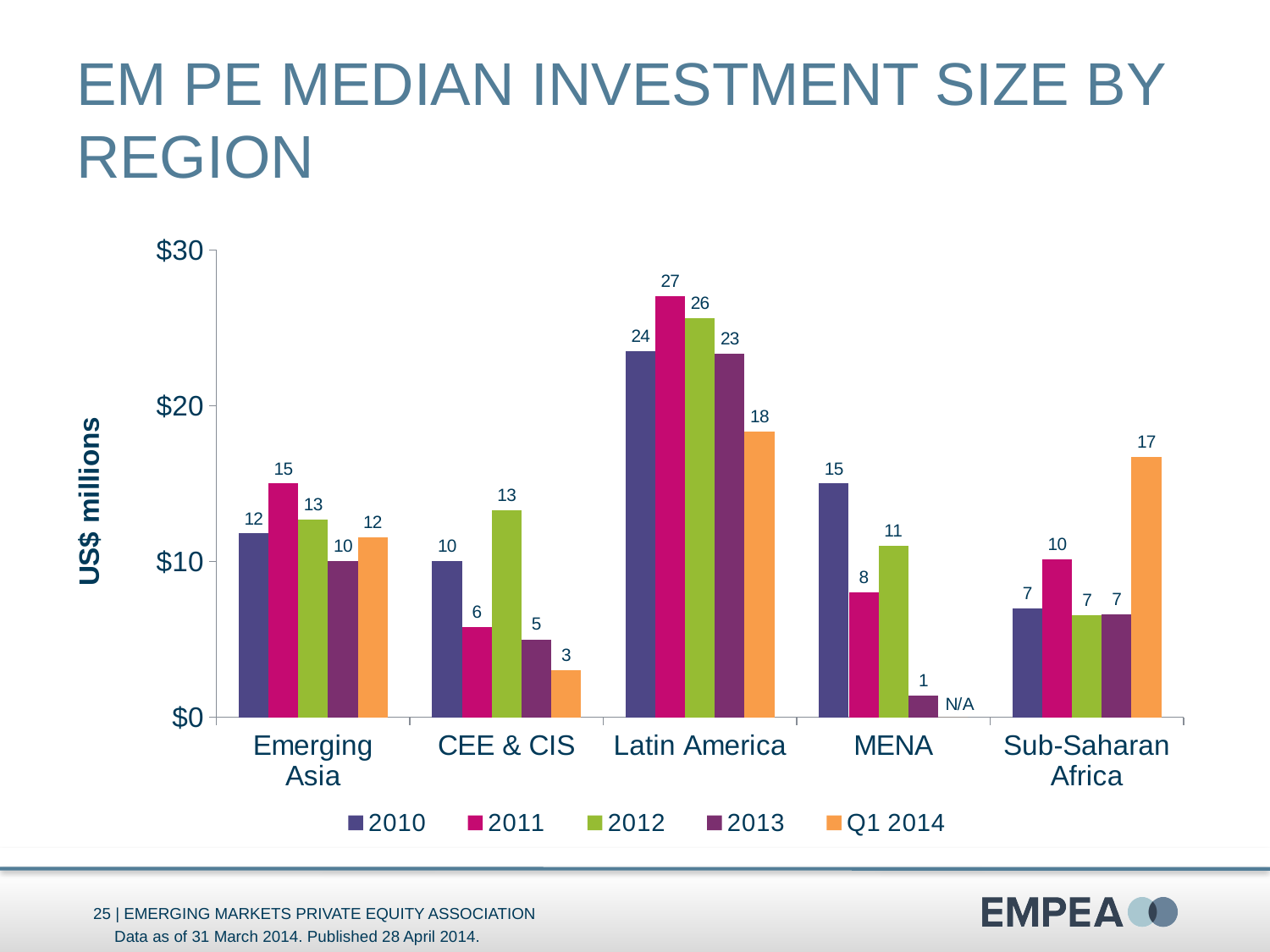
Which is larger for Emerging Asia: the 2011 value or the 2013 value? 2011 Which region has the lowest value in Q1 2014? CEE & CIS How many regions are shown on the x axis? 5 What kind of chart is shown on the slide? Bar chart What is the median investment size for Latin America in 2011? 27 Which region has the highest value in 2012? Latin America What is the value for CEE & CIS in 2013? 5 What is the value for Sub-Saharan Africa in Q1 2014? 17 What is the label on the vertical axis? US$ millions What is shown for MENA in Q1 2014? N/A What is the difference between the 2010 and 2011 values for MENA? 7 How many series does the legend list? 5